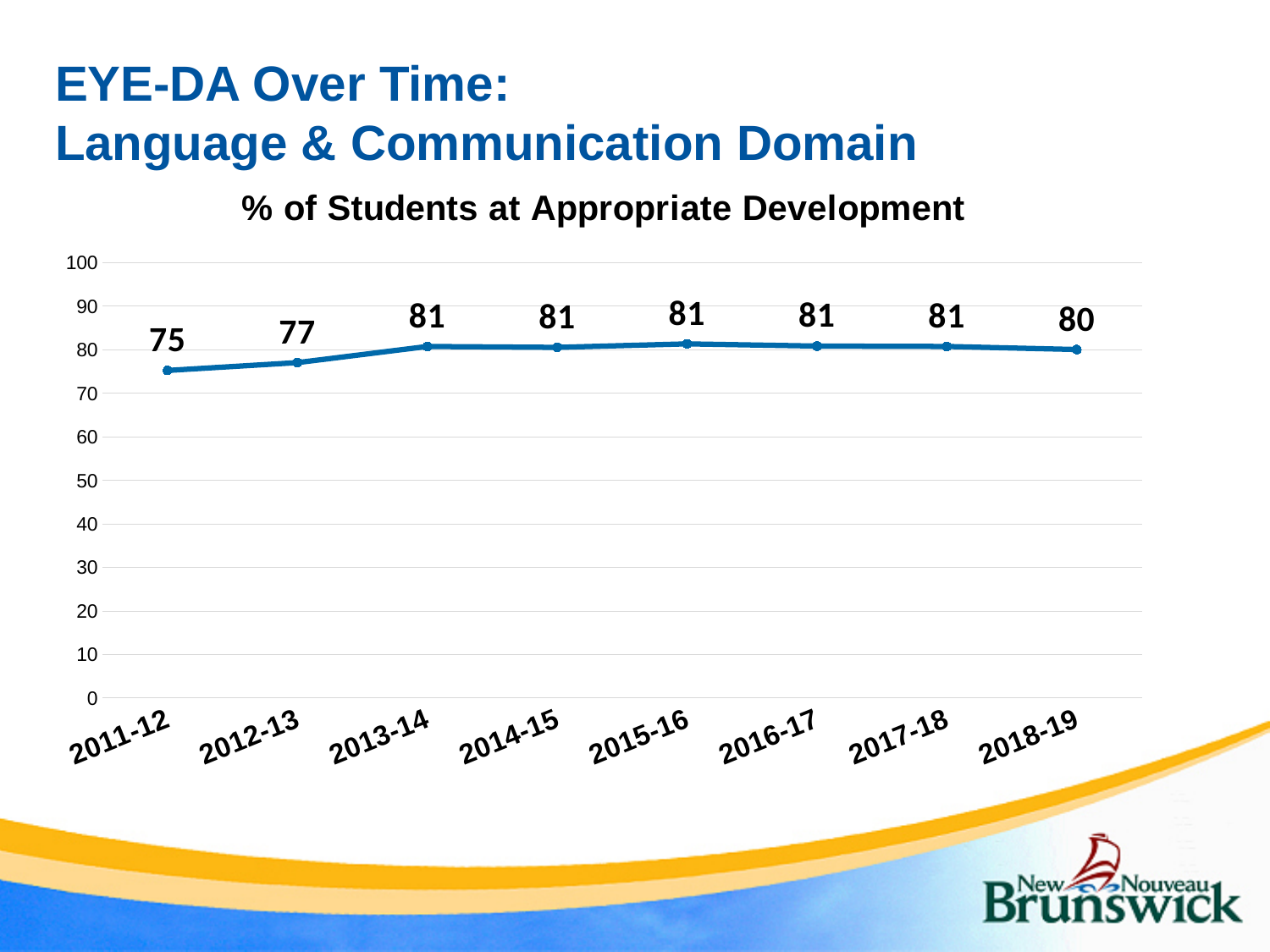
What is the difference between the values for 2018-19 and 2012-13? 3 What is the value for 2011-12? 75 What is the value for 2015-16? 81 Which is larger, the value for 2012-13 or the value for 2018-19? 2018-19 Is the value for 2011-12 greater or less than 80? less What kind of chart is shown on the slide? line chart What is the title of the chart? % of Students at Appropriate Development How many years are plotted on the chart? 8 What is the value for 2018-19? 80 Which year has the lowest value? 2011-12 What is the difference between the values for 2013-14 and 2011-12? 6 What is the value for 2012-13? 77